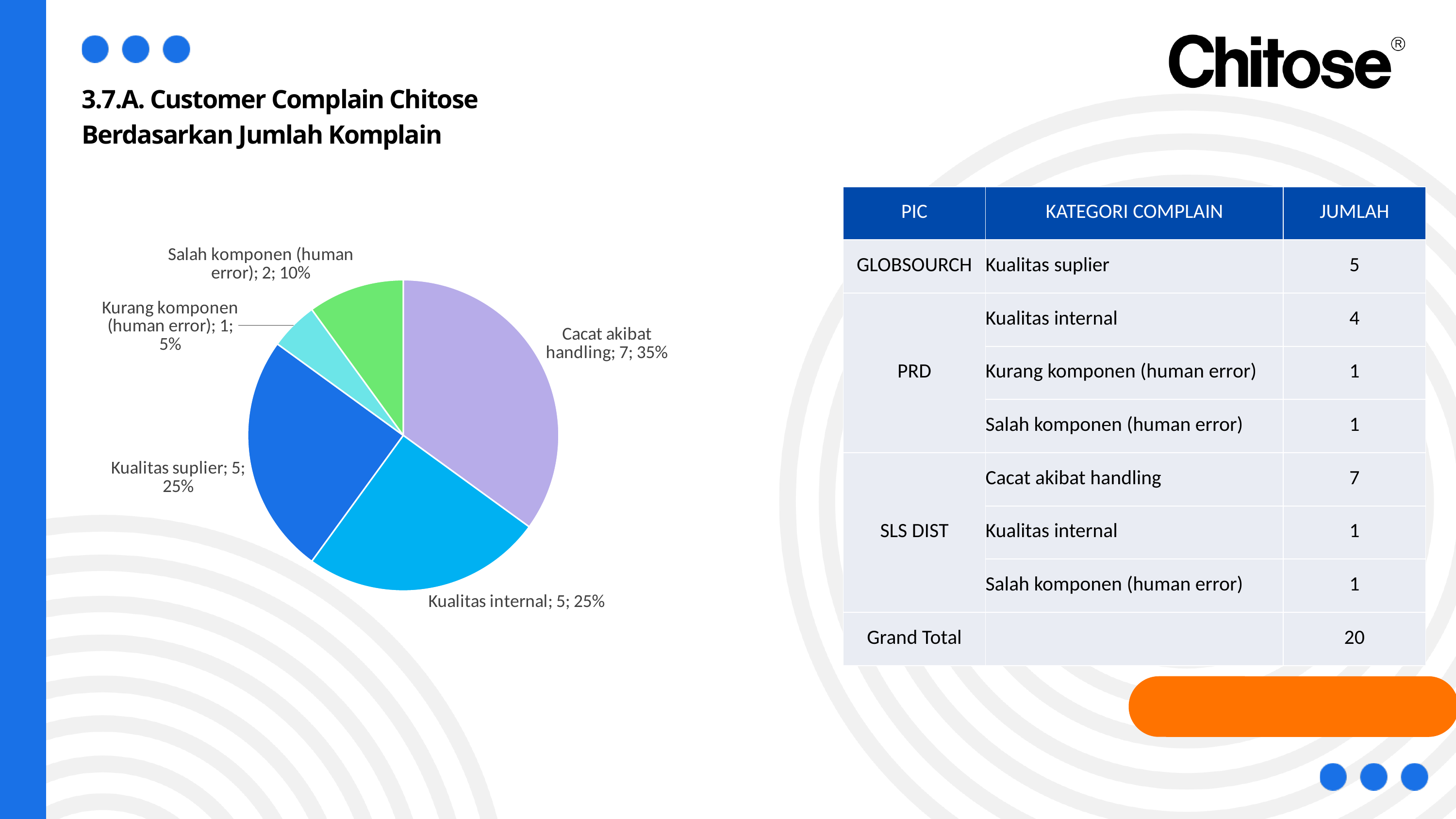
Which category has the largest slice in the pie chart? Cacat akibat handling Which is larger, the value for Salah komponen (human error) or Kurang komponen (human error)? Salah komponen (human error) What is the value for Cacat akibat handling in the pie chart? 7 Which category has the smallest slice in the pie chart? Kurang komponen (human error) What colour is the Cacat akibat handling slice in the pie chart? Purple What is the value for Salah komponen (human error) in the pie chart? 2 What share of the pie does Kurang komponen (human error) represent? 5% What kind of chart is shown on the slide? Pie chart What share of the pie does Kualitas internal represent? 25% What share of the pie does Cacat akibat handling represent? 35% What is the difference between the values for Cacat akibat handling and Kualitas suplier? 2 How many slices does the pie chart have? 5